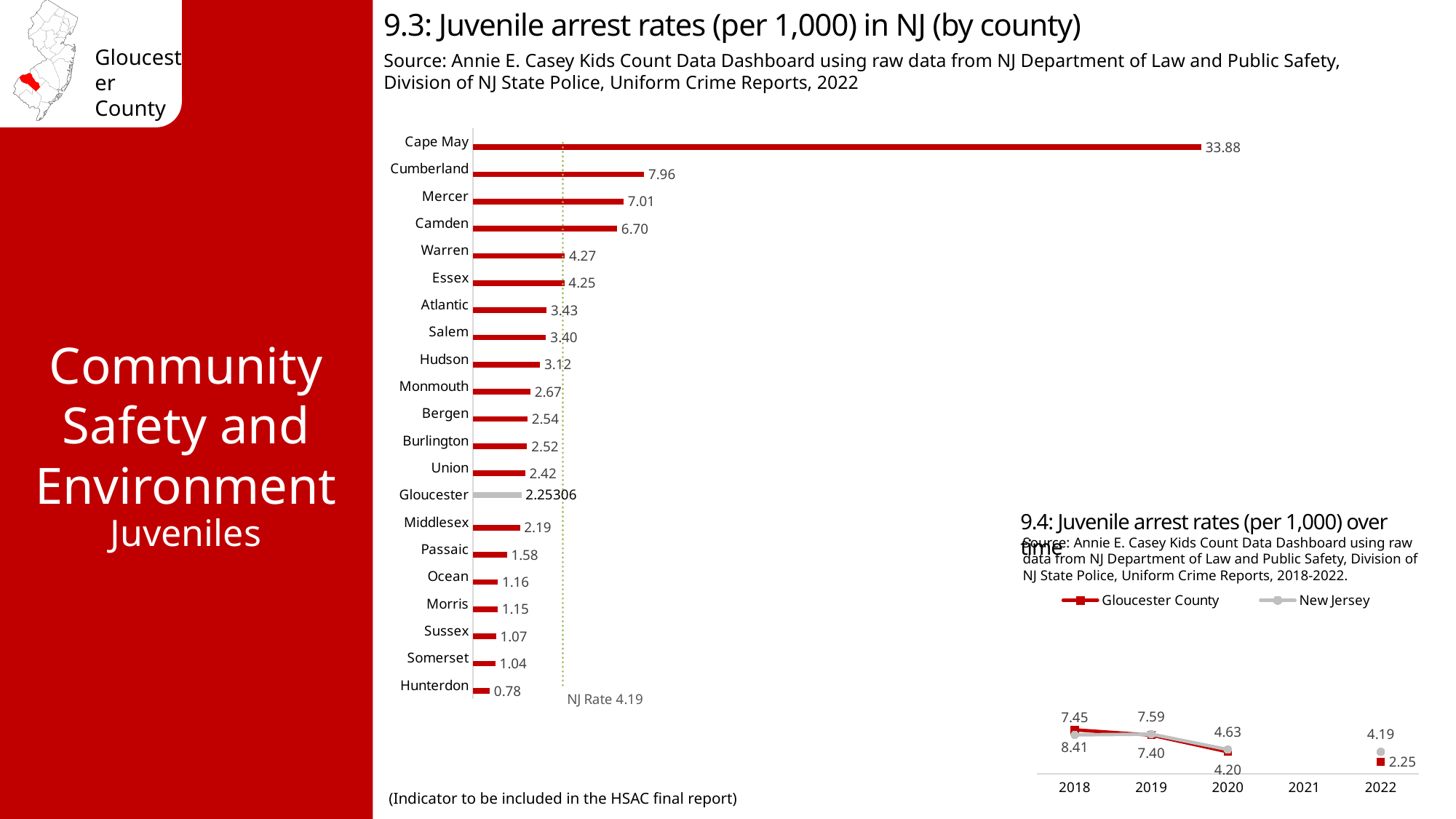
In the chart '9.3: Juvenile arrest rates (per 1,000) in NJ (by county)', what is the value for Cape May? 33.88 In the chart '9.4: Juvenile arrest rates (per 1,000) over time', what is the value for New Jersey in 2022? 4.19 In the chart '9.4: Juvenile arrest rates (per 1,000) over time', how many series does the legend list? 2 In the chart '9.3: Juvenile arrest rates (per 1,000) in NJ (by county)', what is the difference between the values for Cumberland and Mercer? 0.95 In the chart '9.4: Juvenile arrest rates (per 1,000) over time', what is the value for Gloucester County in 2022? 2.25 In the chart '9.3: Juvenile arrest rates (per 1,000) in NJ (by county)', how many counties are shown? 21 What kind of chart is '9.3: Juvenile arrest rates (per 1,000) in NJ (by county)'? Bar chart In the chart '9.3: Juvenile arrest rates (per 1,000) in NJ (by county)', what NJ rate is marked by the dotted reference line? 4.19 In the chart '9.3: Juvenile arrest rates (per 1,000) in NJ (by county)', which has the larger value, Atlantic or Passaic? Atlantic In the chart '9.3: Juvenile arrest rates (per 1,000) in NJ (by county)', what is the value for Camden? 6.70 In the chart '9.3: Juvenile arrest rates (per 1,000) in NJ (by county)', which county has the lowest juvenile arrest rate? Hunterdon In the chart '9.3: Juvenile arrest rates (per 1,000) in NJ (by county)', which county has the highest juvenile arrest rate? Cape May